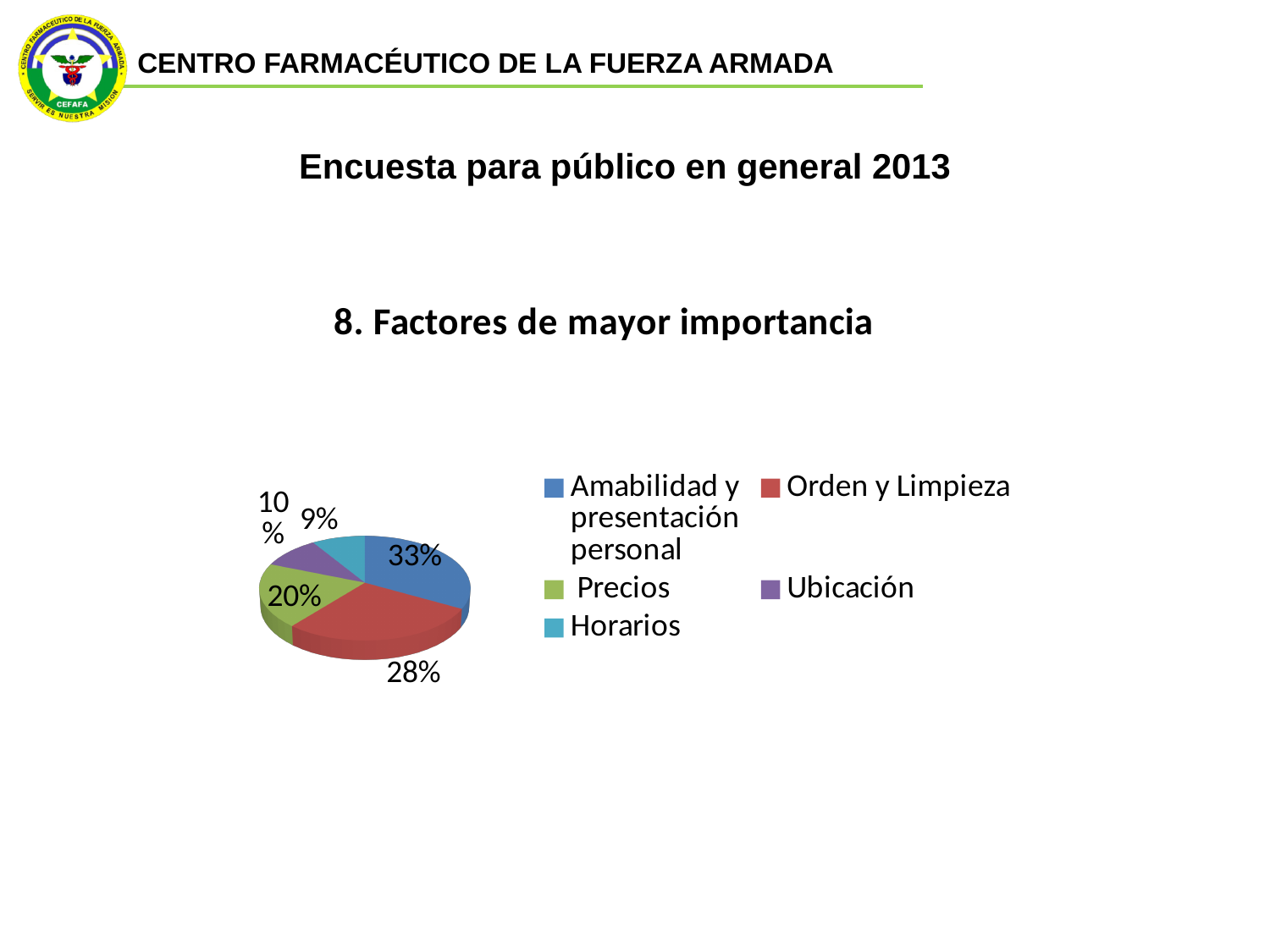
What percentage does the pie chart show for Amabilidad y presentación personal? 33% Which has a larger share, Precios or Ubicación? Precios What percentage does the pie chart show for Precios? 20% What kind of chart is shown on the slide? Pie chart Which factor has the largest share of the pie chart? Amabilidad y presentación personal What percentage does the pie chart show for Ubicación? 10% What percentage does the pie chart show for Horarios? 9% What is the title of the chart on the slide? 8. Factores de mayor importancia Which factor has the smallest share of the pie chart? Horarios What percentage does the pie chart show for Orden y Limpieza? 28% How many slices does the pie chart have? 5 What is the difference in percentage points between Amabilidad y presentación personal and Orden y Limpieza? 5